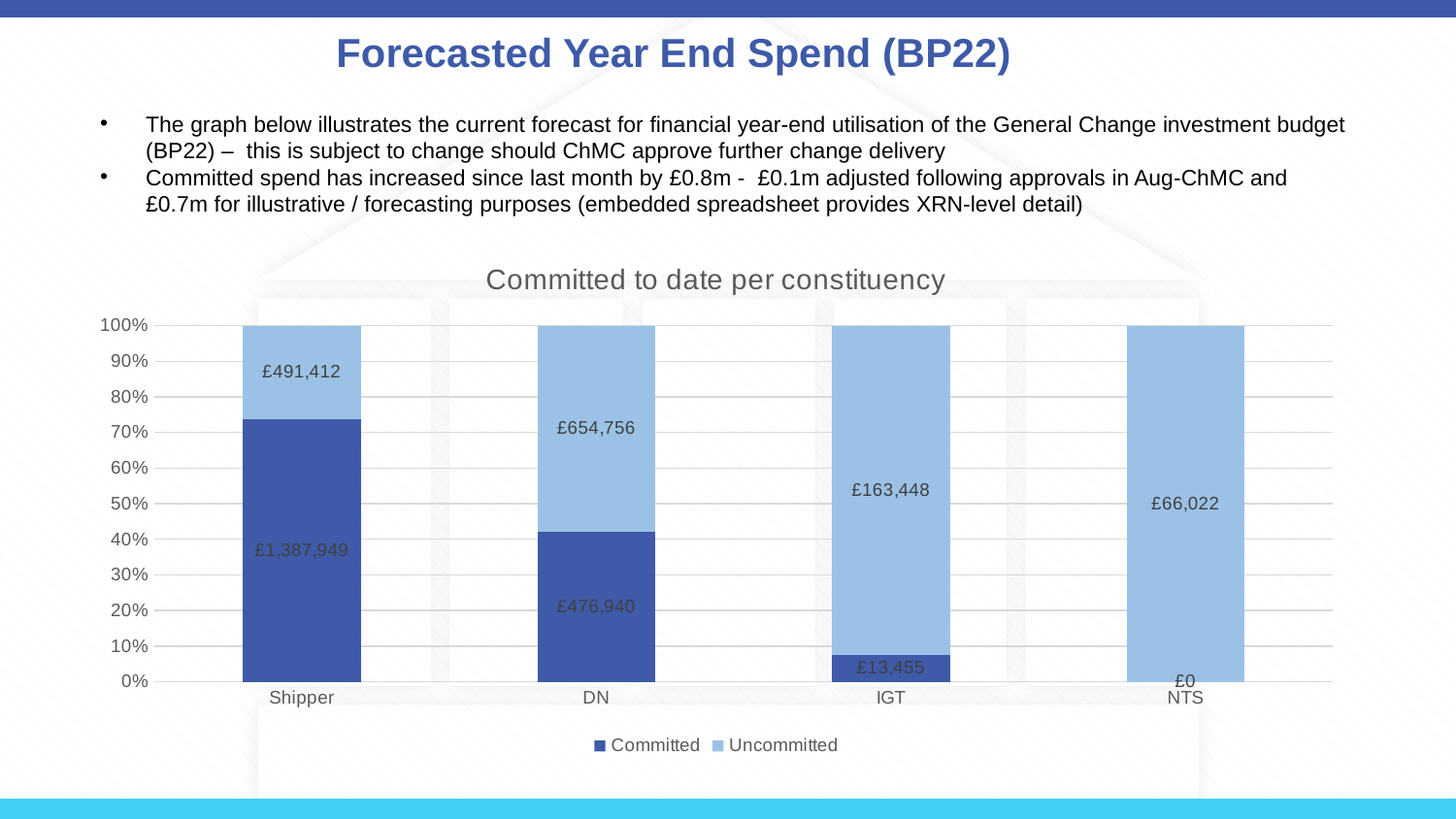
What is the Uncommitted value for DN? £654,756 What is the total of the Committed and Uncommitted values for IGT? £176,903 How many constituencies are shown on the x axis? 4 What is the Committed value for Shipper? £1,387,949 What type of chart is shown on the slide? Stacked bar chart What is the Committed value for NTS? £0 What is the Committed value for IGT? £13,455 Is the Committed share of the Shipper bar greater or less than 70%? greater Which constituency has the lowest Committed value? NTS What is the difference between the Uncommitted and Committed values for DN? £177,816 Which is larger for Shipper, the Committed value or the Uncommitted value? Committed Which constituency has the highest Uncommitted value? DN